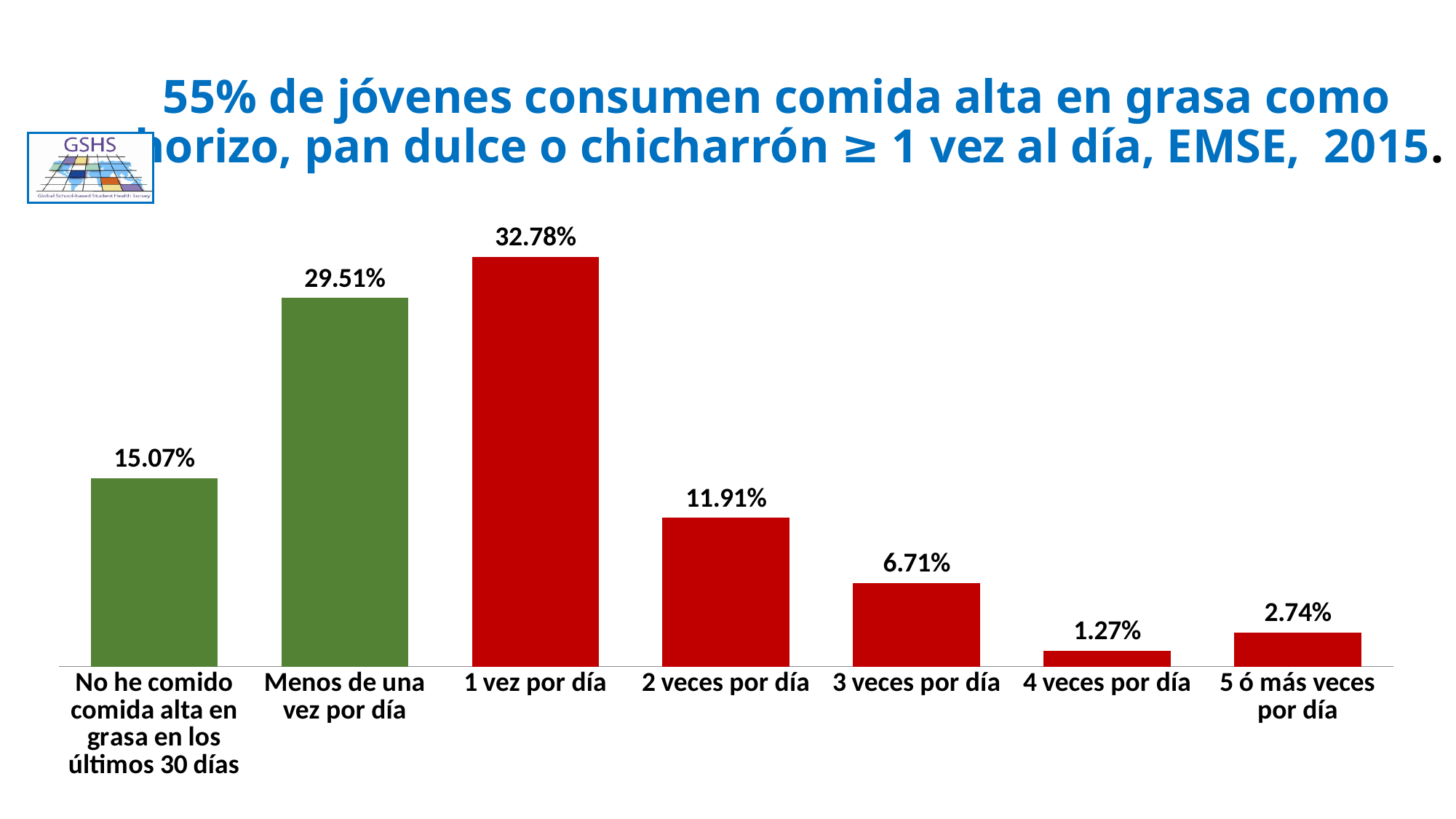
Which category has the lowest value? 4 veces por día Which category has the highest value? 1 vez por día What is the value for "5 ó más veces por día"? 2.74% How many categories are shown in the chart? 7 How many bars are coloured green? 2 What is the value for "4 veces por día"? 1.27% Do the values rise or fall from "1 vez por día" to "4 veces por día"? Fall What kind of chart is shown on the slide? Bar chart What is the value for "1 vez por día"? 32.78% What is the difference between the values for "1 vez por día" and "2 veces por día"? 20.87% Which is larger: the value for "3 veces por día" or the value for "5 ó más veces por día"? 3 veces por día What is the value for "Menos de una vez por día"? 29.51%